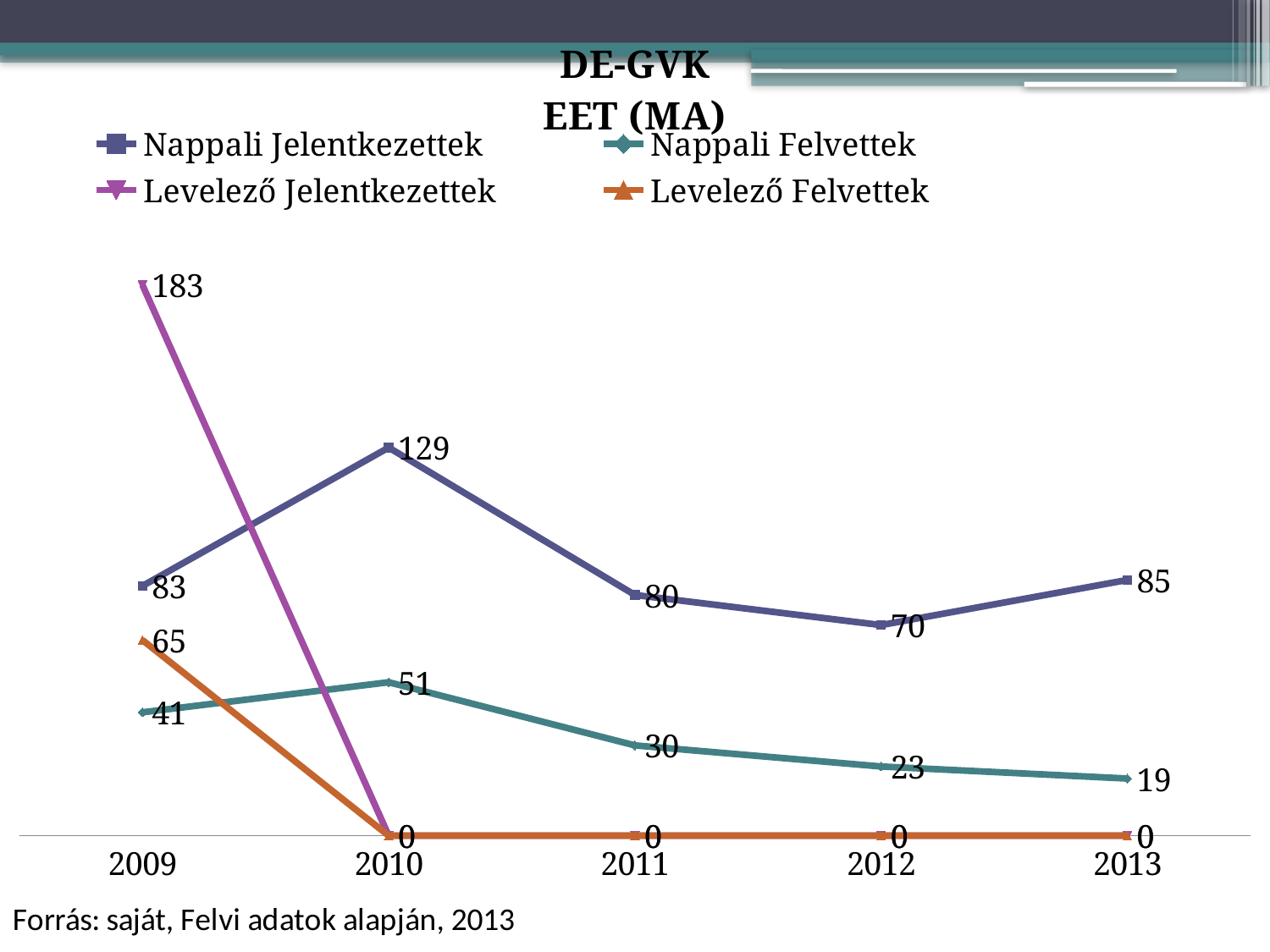
What is the difference between Nappali Jelentkezettek and Nappali Felvettek in 2011? 50 What is the value for Levelező Jelentkezettek in 2009? 183 What is the value for Nappali Jelentkezettek in 2010? 129 What kind of chart is shown on the slide? line chart What is the value for Levelező Felvettek in 2009? 65 How many series does the legend list? 4 Which is larger in 2009: Nappali Jelentkezettek or Levelező Felvettek? Nappali Jelentkezettek In which year is Nappali Felvettek lowest? 2013 Does Nappali Felvettek rise or fall from 2010 to 2013? fall How many years are shown on the x axis? 5 What is the value for Nappali Felvettek in 2013? 19 In which year is Nappali Jelentkezettek highest? 2010